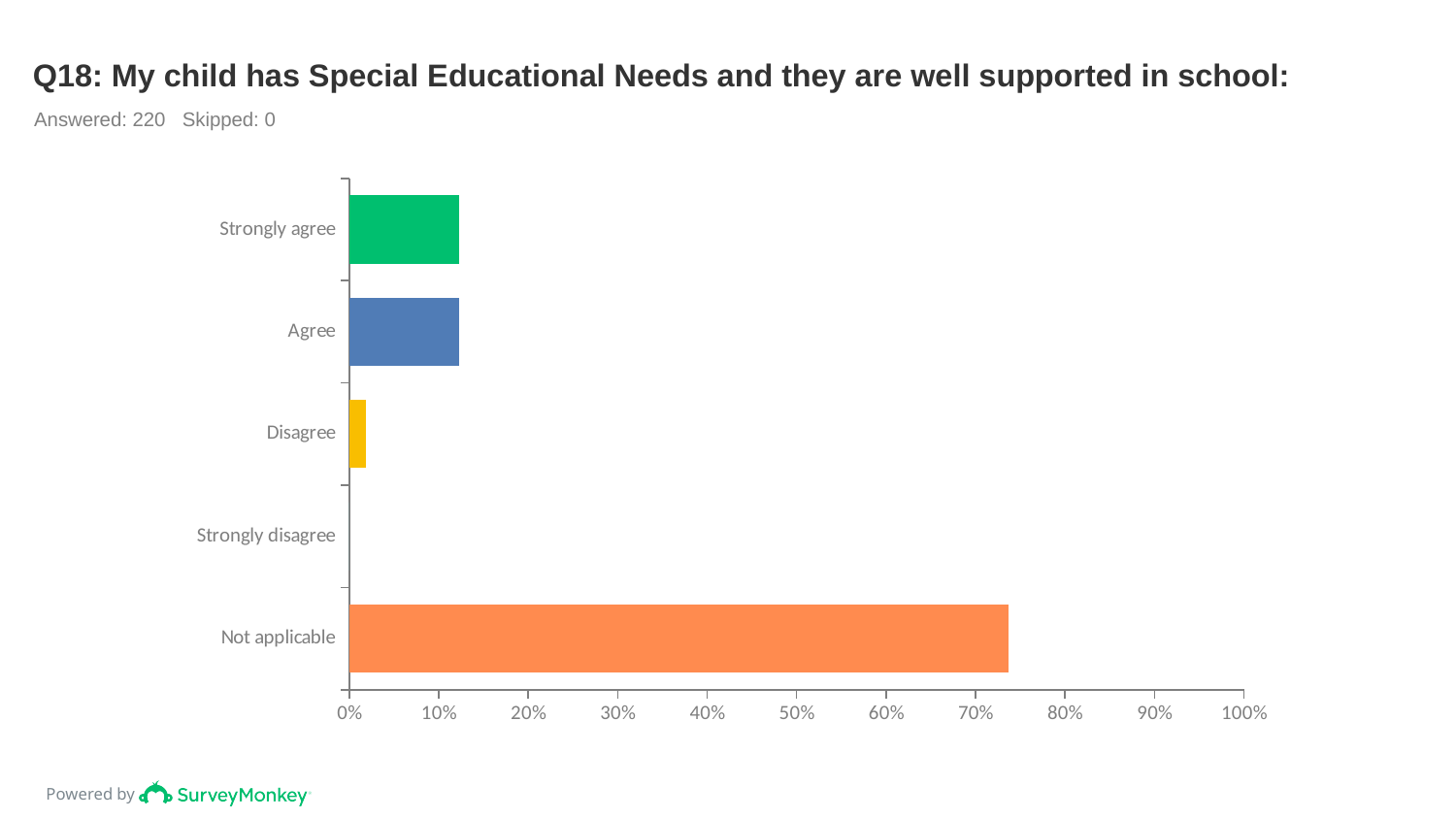
Is the value for Strongly agree greater or less than 10%? greater What kind of chart is shown on the slide? bar chart How many respondents answered this question according to the slide? 220 Which is larger, the value for Not applicable or the value for Agree? Not applicable Is the value for Agree greater or less than 20%? less How many response categories are shown on the chart? 5 Is the value for Not applicable greater or less than 70%? greater Which response category has the highest value? Not applicable Which is larger, the value for Disagree or the value for Strongly agree? Strongly agree Which response category has the lowest value? Strongly disagree